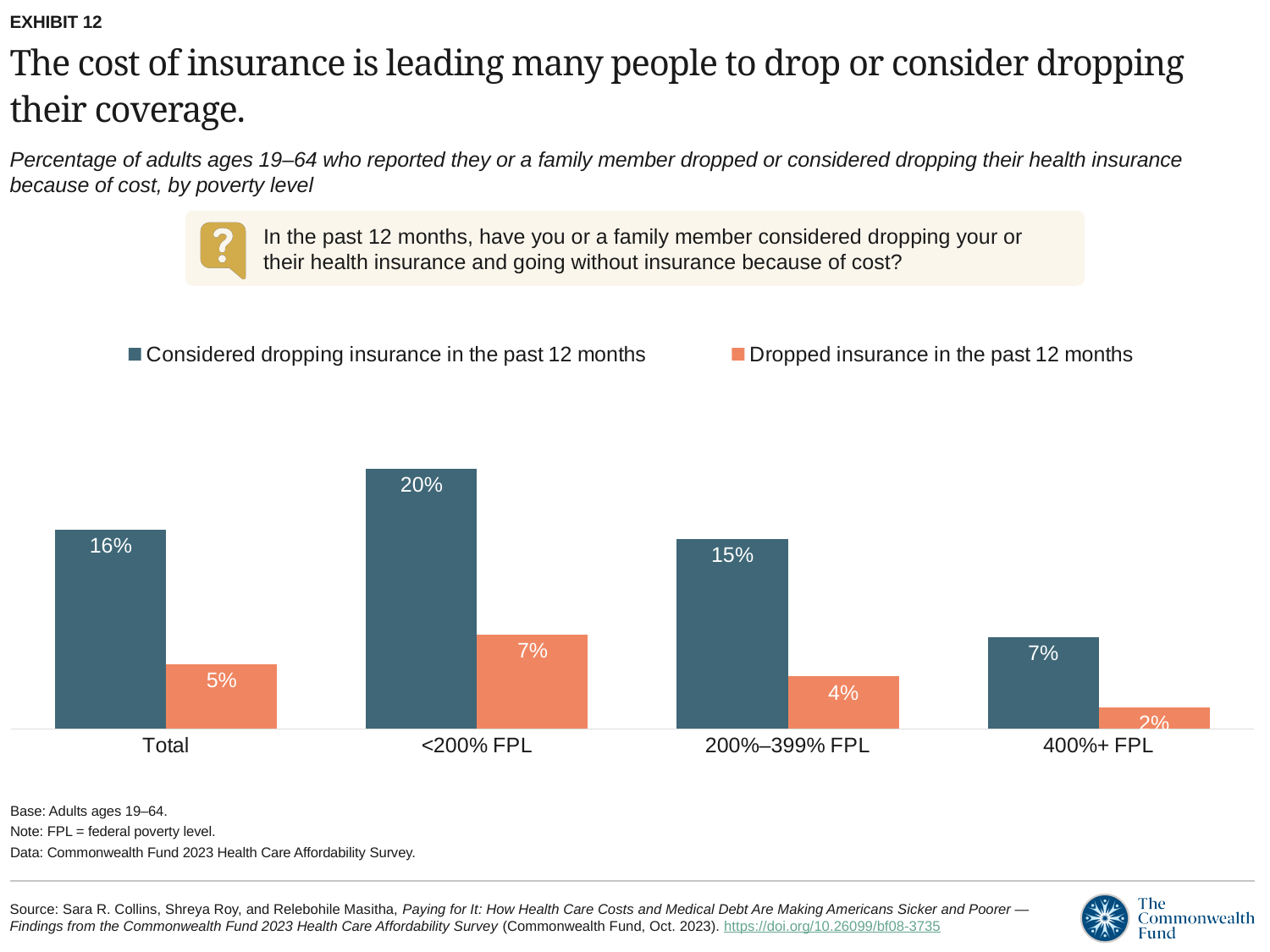
Does the percentage who dropped insurance in the past 12 months rise or fall from <200% FPL to 400%+ FPL? Fall What is the value for 'Dropped insurance in the past 12 months' for the Total category? 5% What percentage of adults in the 400%+ FPL group dropped insurance in the past 12 months? 2% Which colour represents 'Dropped insurance in the past 12 months' in the legend? Orange How many series does the legend list? 2 Which is larger: the percentage who considered dropping insurance in the Total group or in the 200%–399% FPL group? Total How many categories are shown on the x axis of the chart? 4 Which poverty level group has the highest percentage who considered dropping insurance in the past 12 months? <200% FPL What is the difference between the percentage who considered dropping insurance and the percentage who dropped insurance in the 200%–399% FPL group? 11 percentage points What percentage of adults in the <200% FPL group considered dropping insurance in the past 12 months? 20% Which category has the lowest percentage who dropped insurance in the past 12 months? 400%+ FPL What kind of chart is shown on the slide? Bar chart